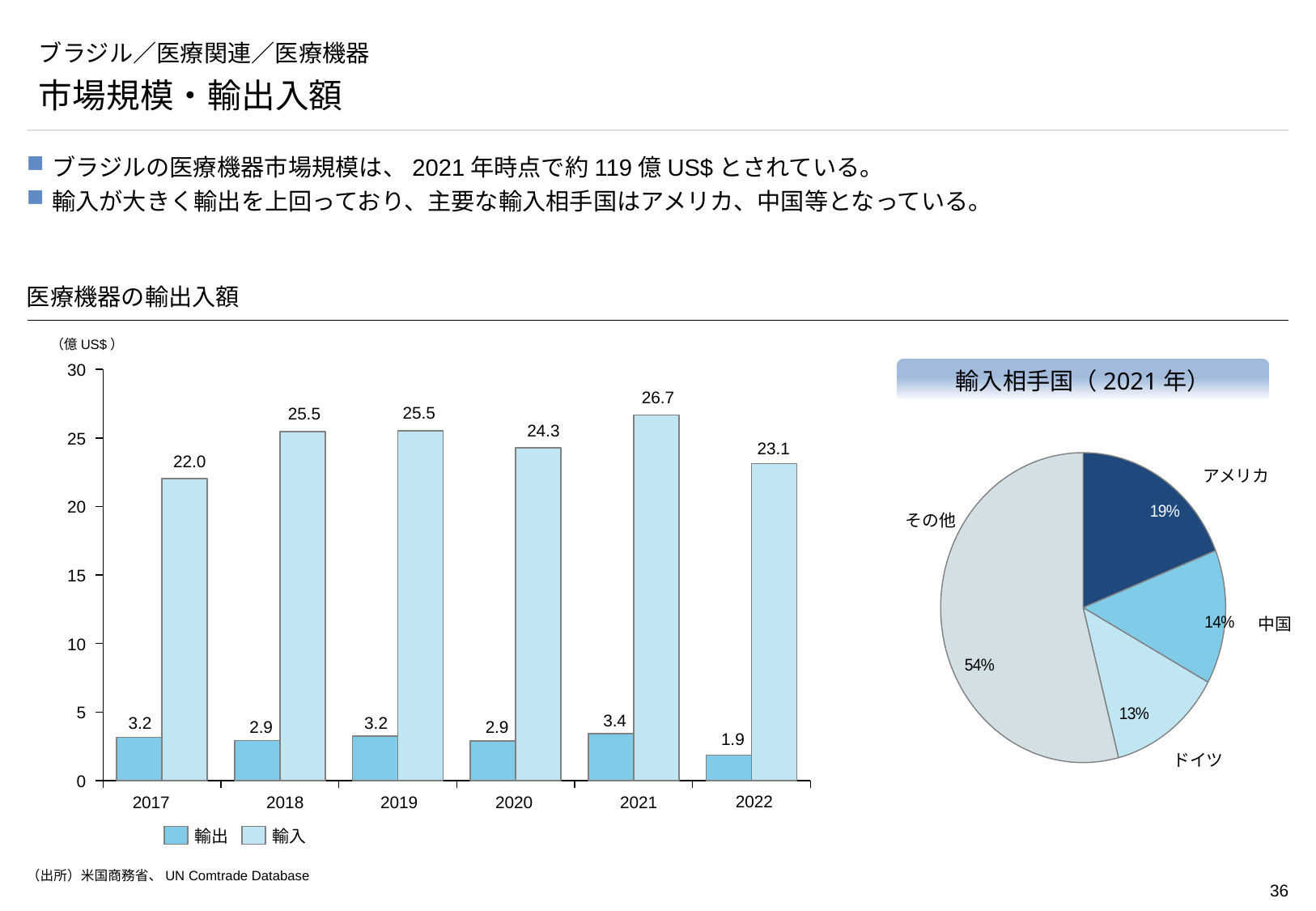
In the bar chart 医療機器の輸出入額, which year has the highest 輸入 value? 2021 In the bar chart 医療機器の輸出入額, how many years are shown on the x axis? 6 In the bar chart 医療機器の輸出入額, what is the 輸出 value for 2022? 1.9 In the pie chart 輸入相手国（2021年）, what share does アメリカ have? 19% In the bar chart 医療機器の輸出入額, what is the difference between the 輸入 and 輸出 values for 2021? 23.3 In the pie chart 輸入相手国（2021年）, how many slices are there? 4 In the pie chart 輸入相手国（2021年）, which slice is the largest? その他 In the bar chart 医療機器の輸出入額, which year has the lowest 輸出 value? 2022 In the bar chart 医療機器の輸出入額, what is the 輸入 value for 2021? 26.7 In the bar chart 医療機器の輸出入額, how many series does the legend list? 2 What kind of chart is 医療機器の輸出入額? bar chart In the bar chart 医療機器の輸出入額, is the 輸入 value for 2020 larger or smaller than the 輸入 value for 2022? larger